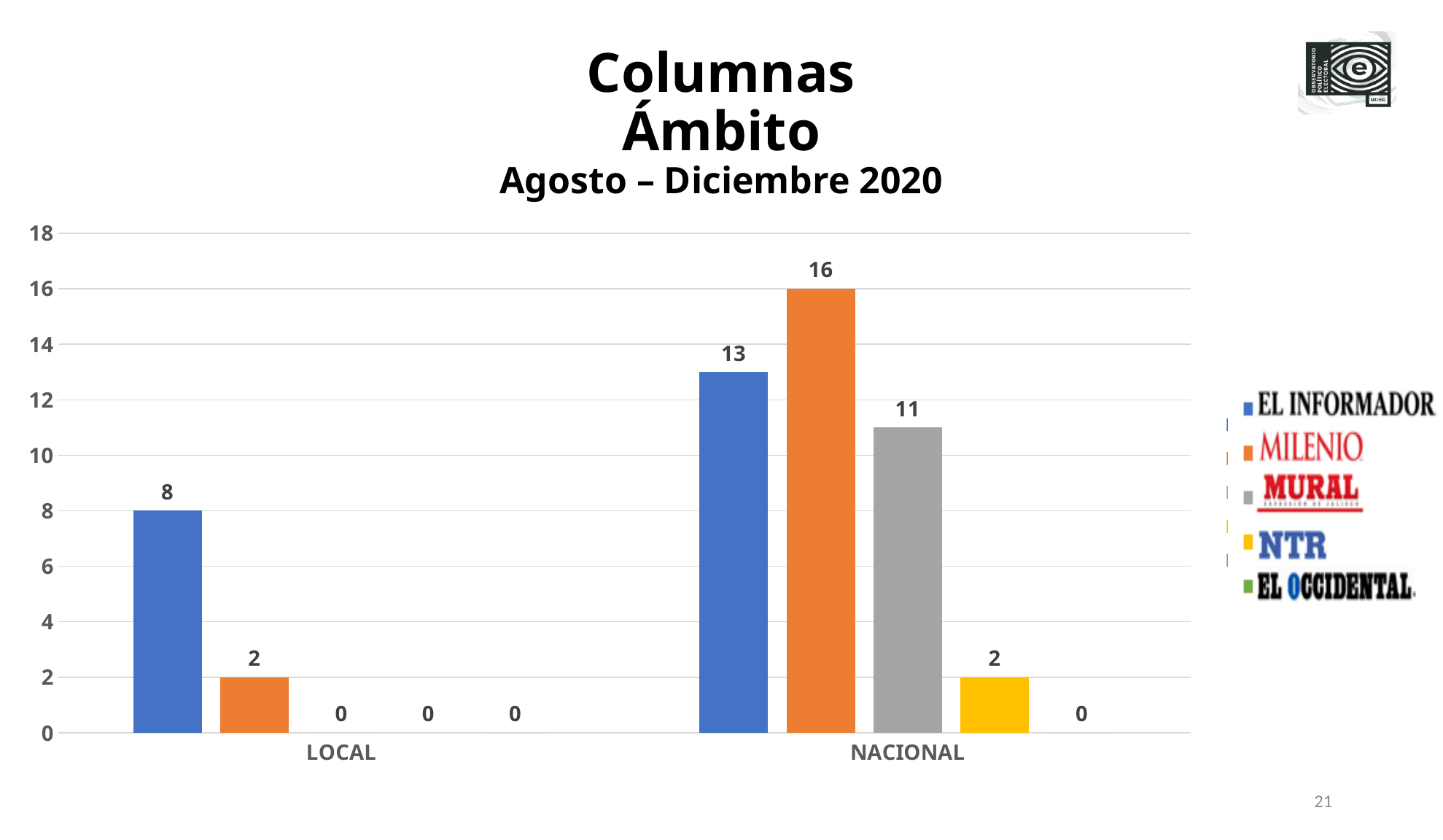
What is the value for Milenio in the LOCAL category? 2 Which series has the highest value in the LOCAL category? El Informador Which series has the highest value in the NACIONAL category? Milenio Which is larger: El Informador's NACIONAL value or Mural's NACIONAL value? El Informador's NACIONAL value How many series does the legend list? 5 What period does the chart subtitle cover? Agosto – Diciembre 2020 What is the value for El Informador in the NACIONAL category? 13 What is the value for Mural in the NACIONAL category? 11 How many categories are shown on the x axis? 2 What is the value for NTR in the NACIONAL category? 2 What is the difference between Milenio's NACIONAL value and its LOCAL value? 14 What kind of chart is shown on the slide? Bar chart